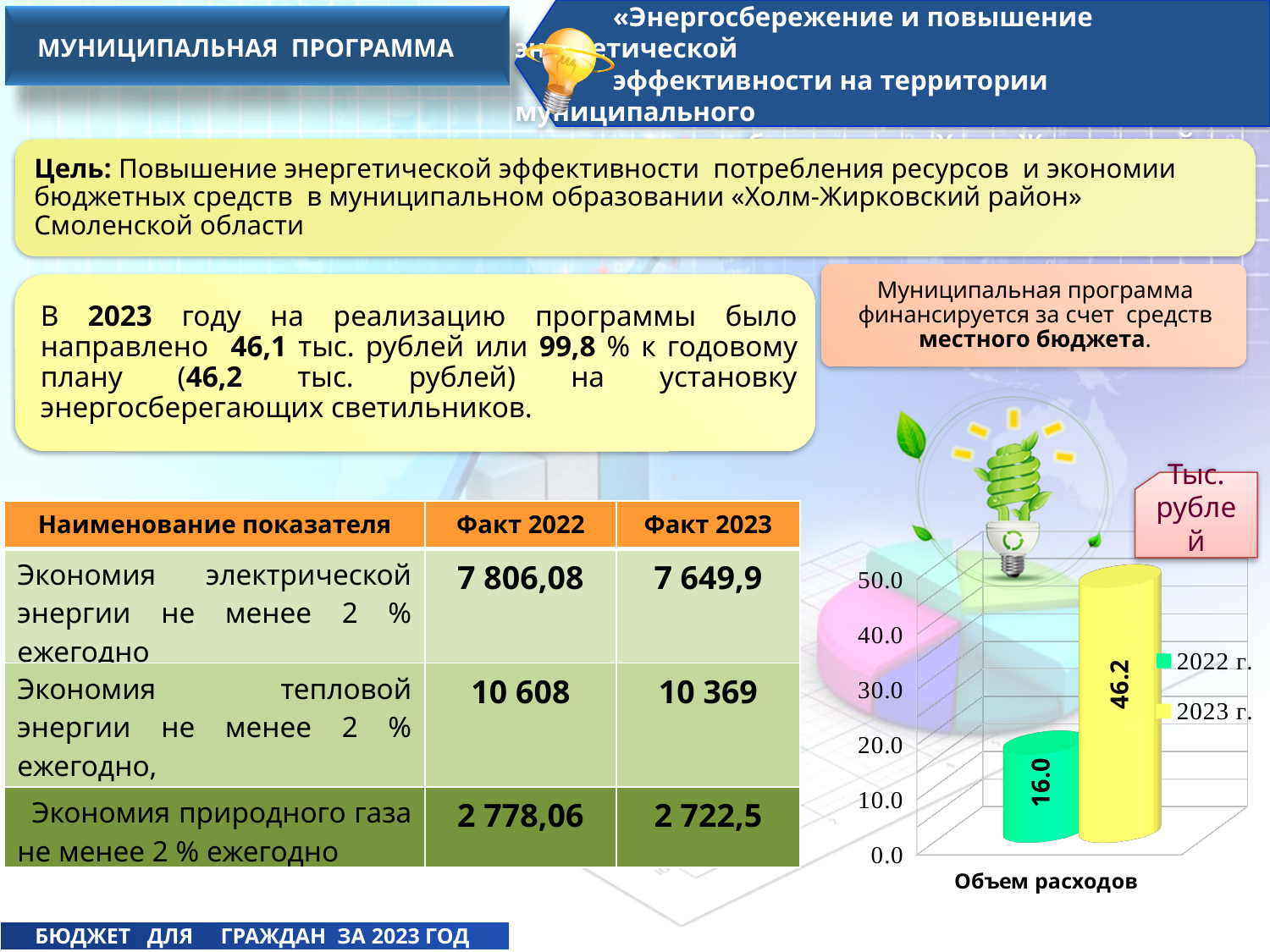
What kind of chart is shown on the slide? bar chart Is the value for 2022 г. greater or less than 20.0? less How many series does the chart legend list? 2 What is the difference between the 2023 г. value and the 2022 г. value in the chart? 30.2 What is the value for 2023 г. in the chart? 46.2 What unit is indicated for the chart values? Тыс. рублей Which series has the higher value in the chart, 2022 г. or 2023 г.? 2023 г. Which series has the lowest value in the chart? 2022 г. What is the value for 2022 г. in the chart? 16.0 What is the category label shown under the bars in the chart? Объем расходов Which series has the highest value in the chart? 2023 г. Is the value for 2023 г. greater or less than 40.0? greater